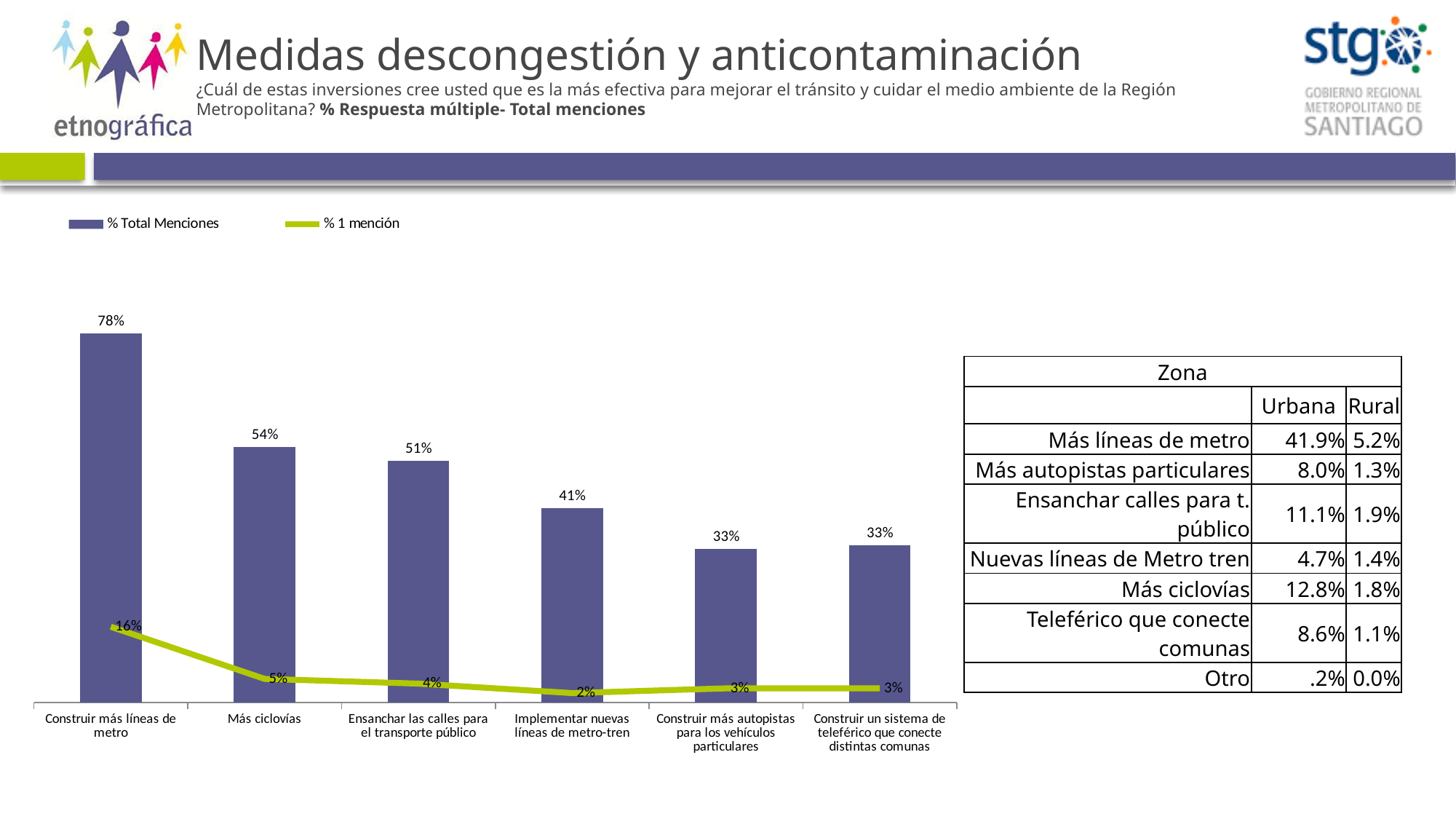
How many categories are shown on the x axis of the chart? 6 What kind of chart is used to show the % Total Menciones series? Bar chart What is the % Total Menciones value for 'Construir más líneas de metro'? 78% What colour is the line for the % 1 mención series? Green Which category has the lowest % 1 mención value? Implementar nuevas líneas de metro-tren What is the difference in % Total Menciones between 'Construir más líneas de metro' and 'Más ciclovías'? 24% Do the % Total Menciones values rise or fall from left to right across the categories? Fall What is the % 1 mención value for 'Más ciclovías'? 5% How many series does the chart legend list? 2 Which has a higher % Total Menciones: 'Más ciclovías' or 'Ensanchar las calles para el transporte público'? Más ciclovías What is the % Total Menciones value for 'Implementar nuevas líneas de metro-tren'? 41% Which category has the highest % Total Menciones? Construir más líneas de metro